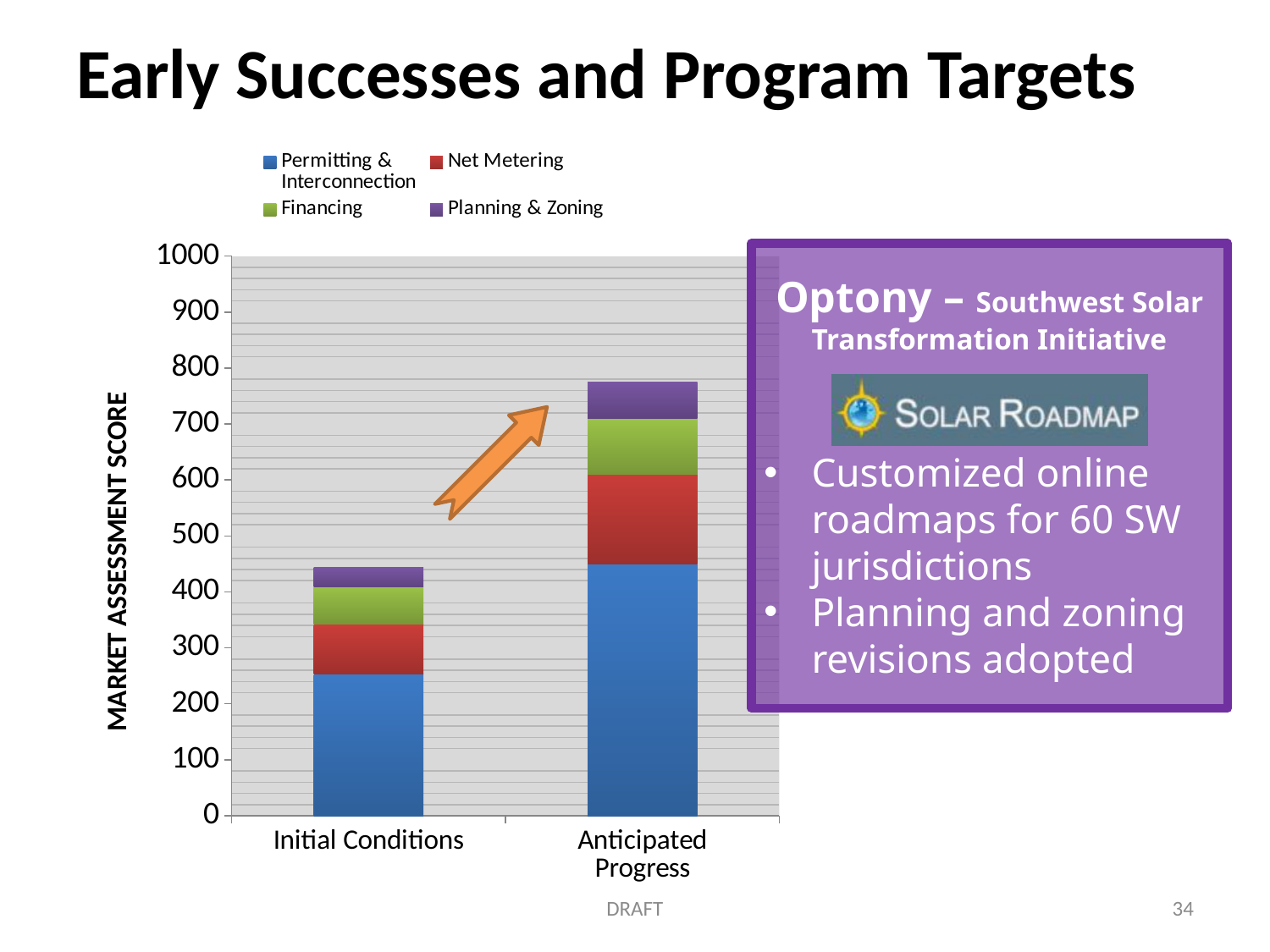
Is the total stacked value for Anticipated Progress greater or less than 700? greater Is the total stacked value for Initial Conditions greater or less than 500? less Which category has the taller stacked bar, Initial Conditions or Anticipated Progress? Anticipated Progress Which series is shown in blue in the chart's legend? Permitting & Interconnection What kind of chart is shown on the slide? Stacked bar chart Is the Permitting & Interconnection value for Initial Conditions greater or less than 300? less How many series does the chart's legend list? 4 How many categories are shown on the x axis of the chart? 2 What is the title of the chart's vertical axis? MARKET ASSESSMENT SCORE Do the stacked totals rise or fall from Initial Conditions to Anticipated Progress? rise Which series makes up the largest segment of the Anticipated Progress bar? Permitting & Interconnection